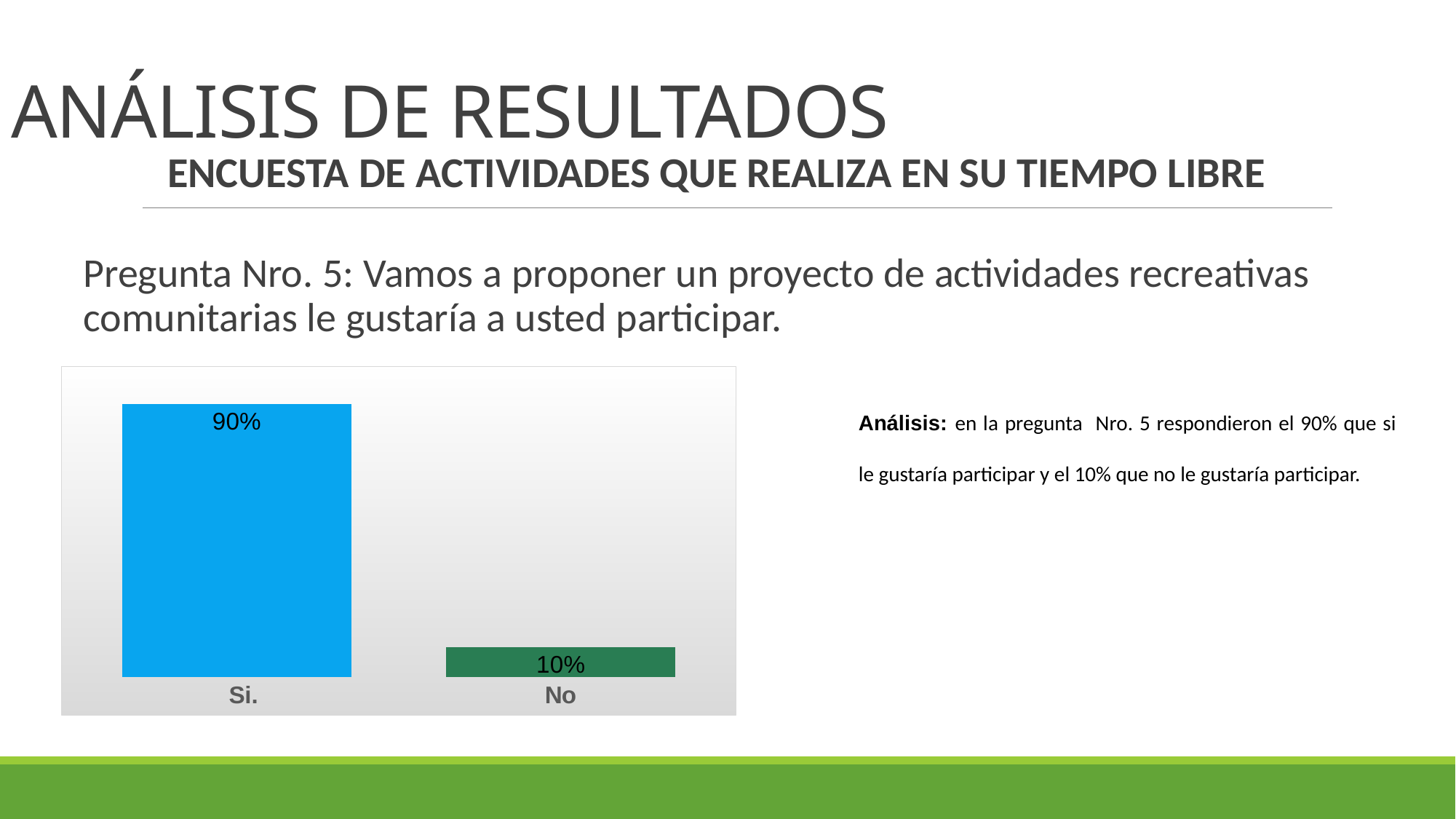
What kind of chart is shown on the slide? Bar chart Which category has the lowest value? No What colour is the bar for "No"? Green What is the value for "Si."? 90% What is the difference between the values for "Si." and "No"? 80% What is the total of the values for "Si." and "No"? 100% Which category has the highest value? Si. What is the value for "No"? 10% What colour is the bar for "Si."? Blue Which is larger, the value for "Si." or the value for "No"? Si. How many categories are shown in the chart? 2